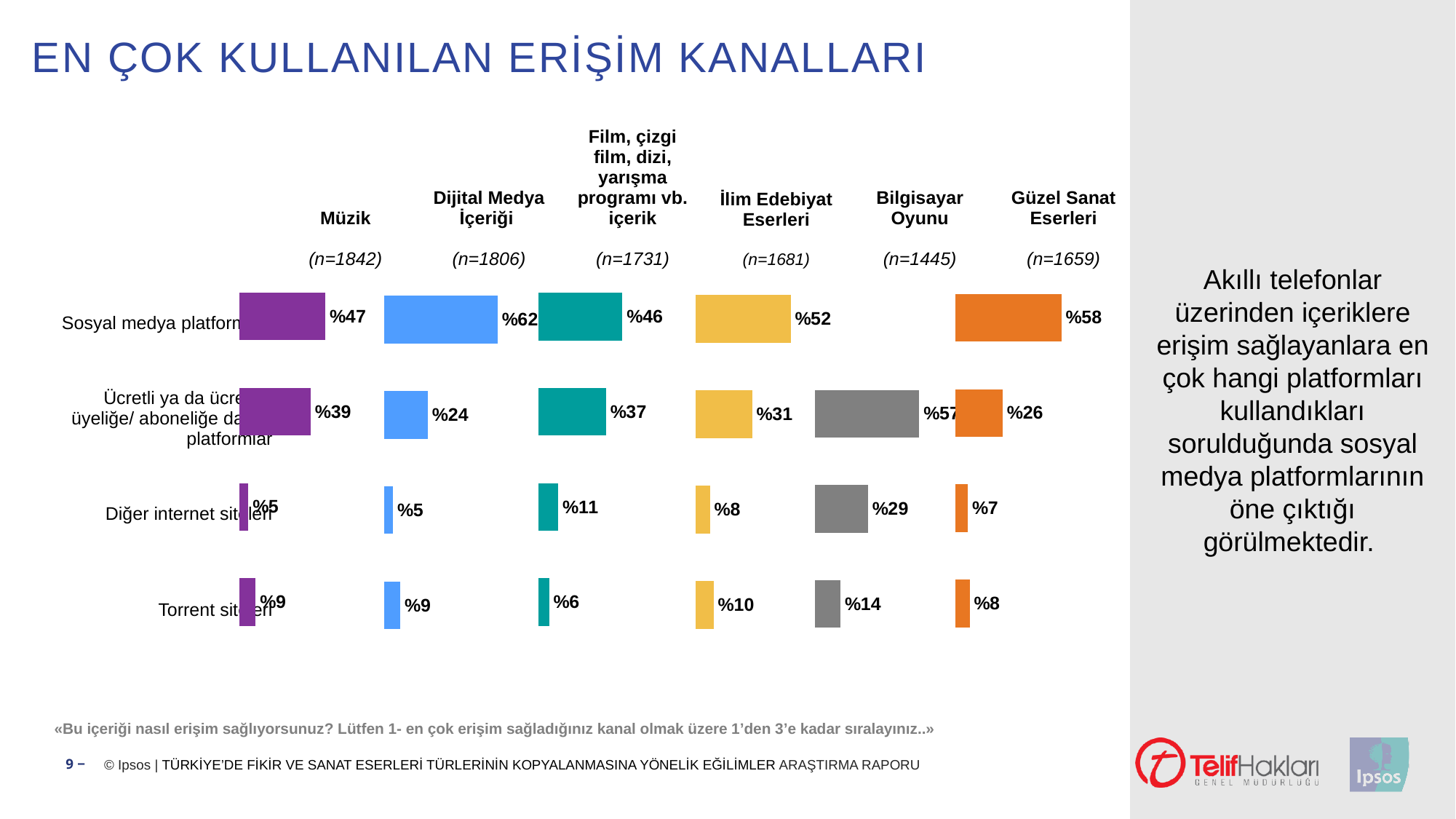
How many content-type charts are shown on the slide? 6 In the Güzel Sanat Eserleri chart, what is the value for Diğer internet siteleri? %7 In the İlim Edebiyat Eserleri chart, which category has the highest value? Sosyal medya platformları In the Film, çizgi film, dizi, yarışma programı vb. içerik chart, which category has the lowest value? Torrent siteleri In the Müzik chart, what is the value for Sosyal medya platformları? %47 In the Bilgisayar Oyunu chart, what is the value for Torrent siteleri? %14 Which is larger: the Sosyal medya platformları value in the Müzik chart or in the Güzel Sanat Eserleri chart? Güzel Sanat Eserleri In the Bilgisayar Oyunu chart, what is the value for Diğer internet siteleri? %29 In the Dijital Medya İçeriği chart, what is the value for Sosyal medya platformları? %62 What kind of chart is used on the slide? Bar chart In the Dijital Medya İçeriği chart, what is the difference between the values for Sosyal medya platformları and Ücretli ya da ücretsiz üyeliğe/aboneliğe dayalı platformlar? 38 What is the sample size (n) shown for the Müzik chart? n=1842